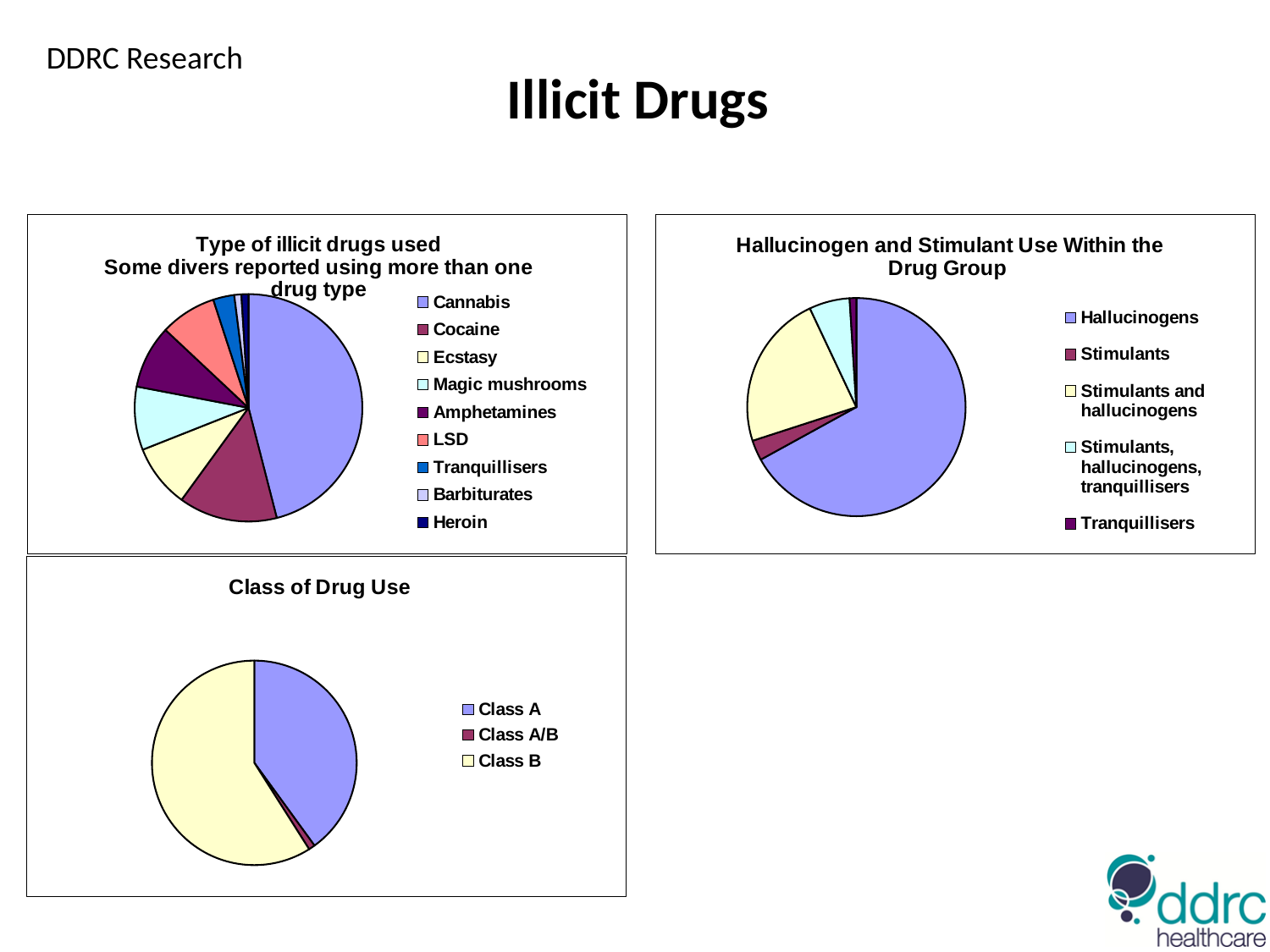
How many categories does the legend of the 'Hallucinogen and Stimulant Use Within the Drug Group' chart list? 5 In the 'Hallucinogen and Stimulant Use Within the Drug Group' chart, which category has the largest slice? Hallucinogens In the 'Hallucinogen and Stimulant Use Within the Drug Group' chart, which slice is larger, 'Stimulants' or 'Stimulants and hallucinogens'? Stimulants and hallucinogens In the 'Class of Drug Use' chart, which class has the smallest slice? Class A/B What kind of chart is the 'Class of Drug Use' chart? Pie chart In the 'Class of Drug Use' chart, which class has the largest slice? Class B In the 'Type of illicit drugs used' chart, which drug type has the largest slice? Cannabis In the 'Type of illicit drugs used' chart, which slice is larger, Cannabis or Cocaine? Cannabis In the 'Hallucinogen and Stimulant Use Within the Drug Group' chart, which category has the smallest slice? Tranquillisers How many pie charts are shown on the slide? 3 In the 'Type of illicit drugs used' chart, which slice is larger, Cocaine or LSD? Cocaine How many drug types does the legend of the 'Type of illicit drugs used' chart list? 9